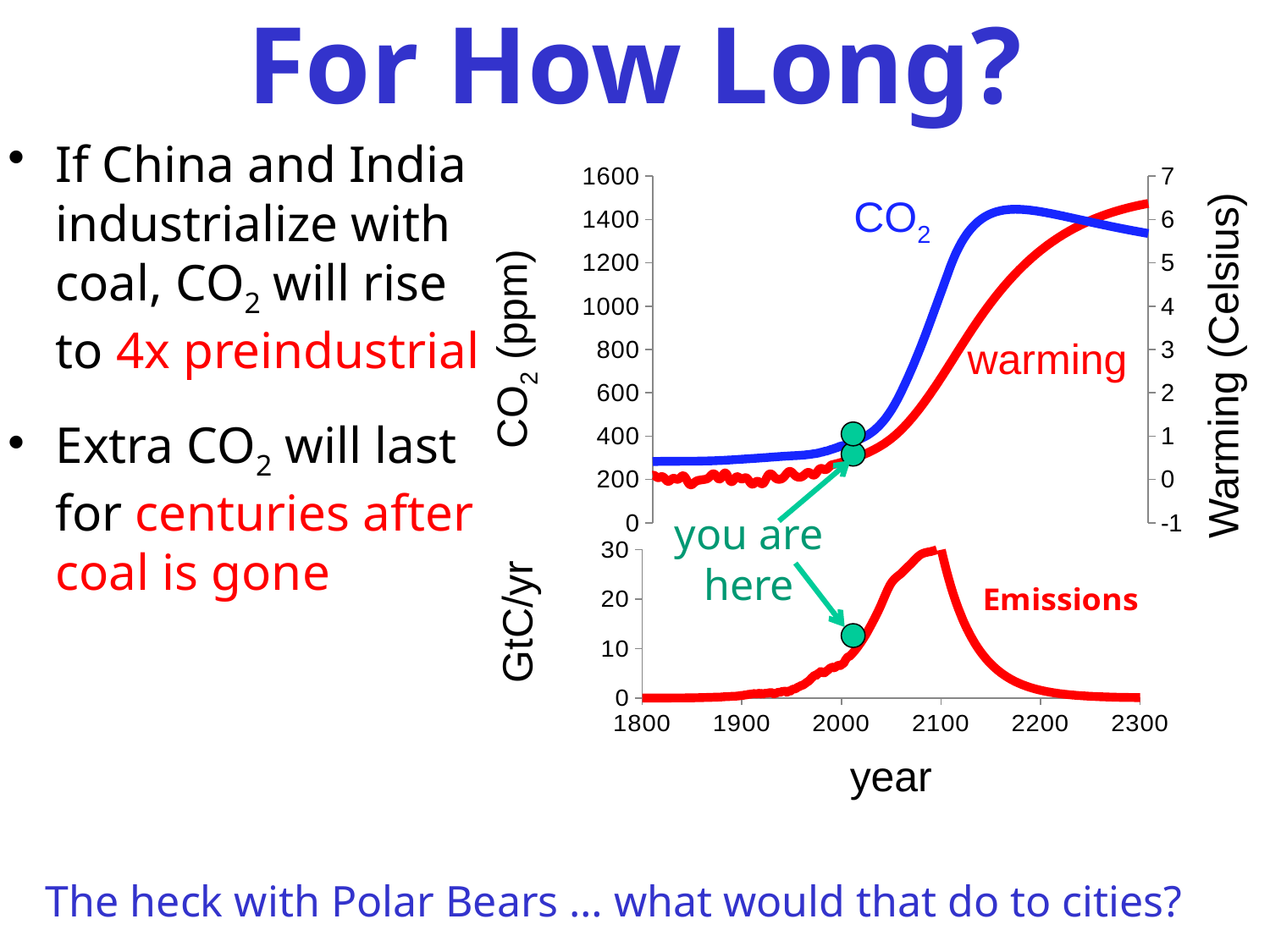
In the top chart, what is the label on the right-hand y axis? Warming (Celsius) What kind of chart is the top chart showing CO2 and warming? line chart In the top chart, is the CO2 value in 2300 greater or less than 1200 ppm? greater In the bottom Emissions chart, is the emissions value in 2300 greater or less than 10 GtC/yr? less In the top chart, does the warming line rise or fall between 1900 and 2300? rise In the top chart, is the CO2 value in 2100 greater or less than 800 ppm? greater In the bottom Emissions chart, are emissions higher in 2100 or in 2300? 2100 In the bottom Emissions chart, do emissions rise or fall between 2100 and 2300? fall In the top chart, which series is drawn in blue? CO2